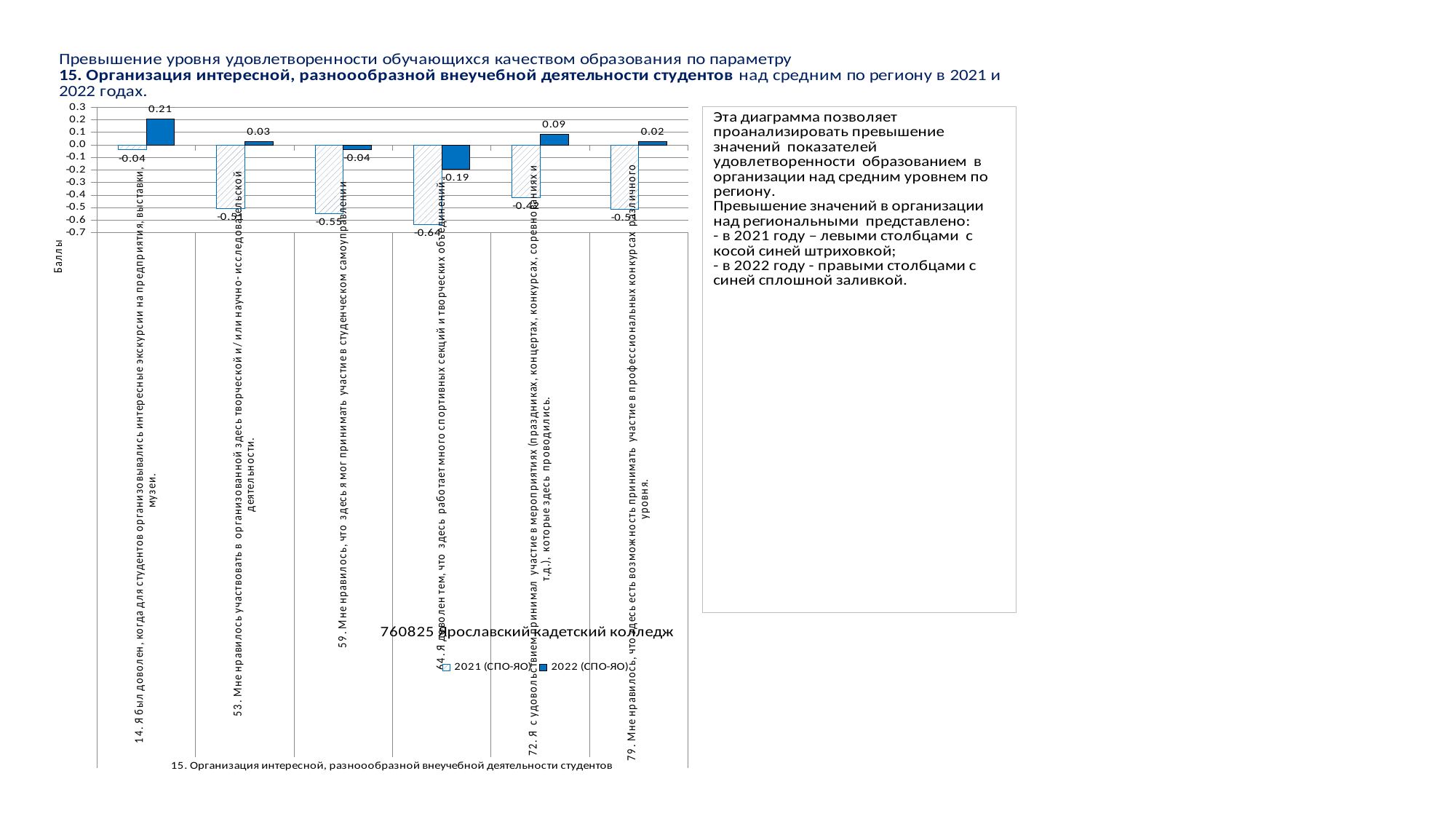
Which has the larger 2022 (СПО-ЯО) value: statement 72 or statement 79? statement 72 How many categories (statements) are plotted on the x axis? 6 What kind of chart is shown on the slide? bar chart What is the 2022 (СПО-ЯО) value for statement 64 (Я доволен тем, что здесь работает много спортивных секций...)? -0.19 How many series does the chart legend list? 2 What is the 2021 (СПО-ЯО) value for statement 59 (Мне нравилось, что здесь я мог принимать участие в студенческом самоуправлении)? -0.55 Which statement has the lowest 2021 (СПО-ЯО) value? 64. Я доволен тем, что здесь работает много спортивных секций и творческих объединений What are the two series named in the legend? 2021 (СПО-ЯО) and 2022 (СПО-ЯО) What is the difference between the 2022 and 2021 values for statement 14? 0.25 What is the 2021 (СПО-ЯО) value for statement 14 (Я был доволен, когда для студентов организовывались интересные экскурсии...)? -0.04 What is the 2022 (СПО-ЯО) value for statement 14 (Я был доволен, когда для студентов организовывались интересные экскурсии...)? 0.21 Which statement has the highest 2022 (СПО-ЯО) value? 14. Я был доволен, когда для студентов организовывались интересные экскурсии на предприятия, выставки, музеи.